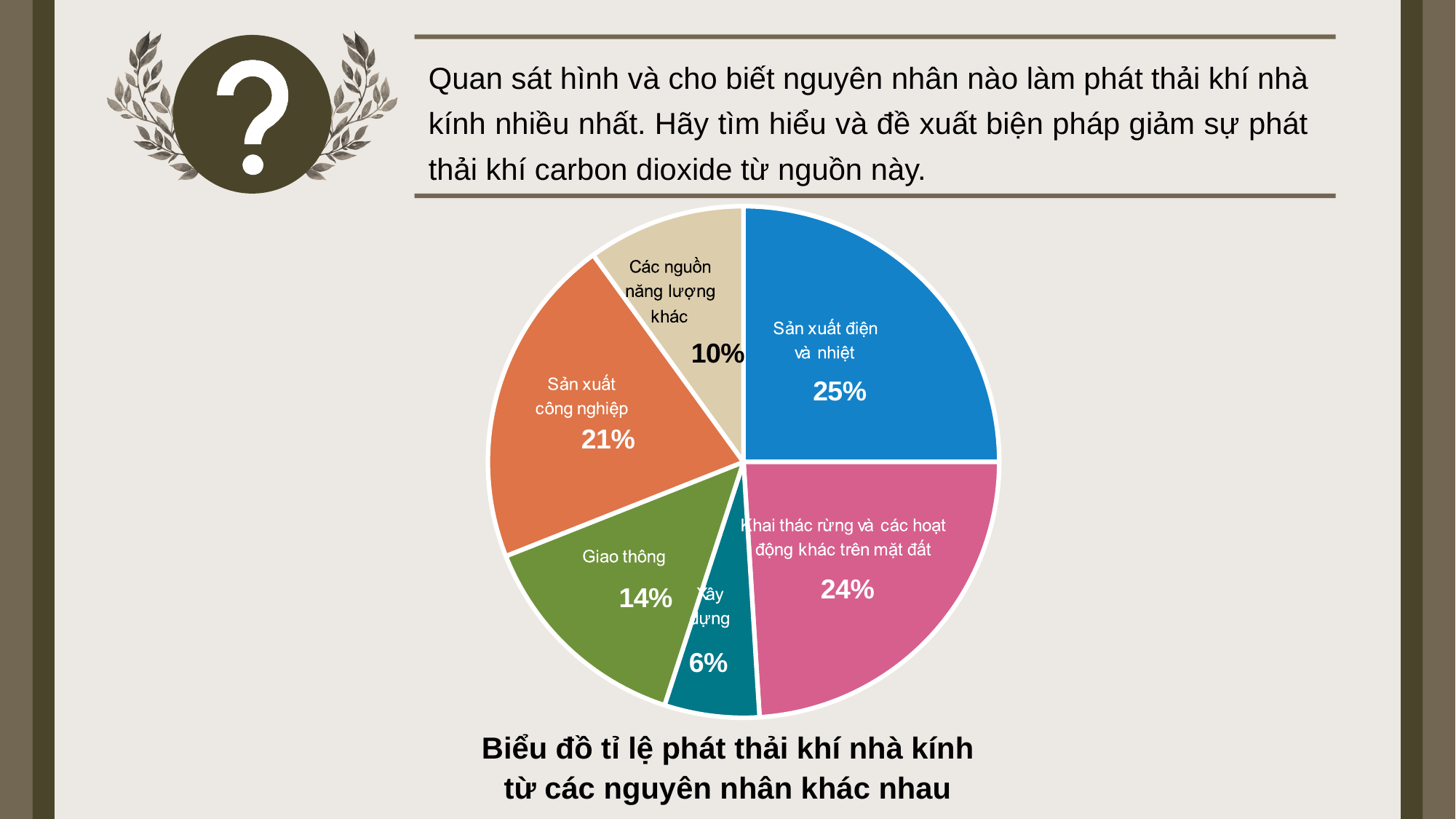
How many slices does the pie chart have? 6 What is the title of the pie chart? Biểu đồ tỉ lệ phát thải khí nhà kính từ các nguyên nhân khác nhau What share of greenhouse gas emissions comes from "Sản xuất điện và nhiệt"? 25% Which is larger: the share for "Khai thác rừng và các hoạt động khác trên mặt đất" or the share for "Sản xuất công nghiệp"? Khai thác rừng và các hoạt động khác trên mặt đất What percentage is shown for "Xây dựng"? 6% Which source has the smallest share of emissions in the pie chart? Xây dựng What kind of chart is shown on the slide? pie chart Which source has the largest share of emissions in the pie chart? Sản xuất điện và nhiệt What percentage is shown for "Giao thông"? 14% What is the difference in percentage points between "Sản xuất công nghiệp" and "Giao thông"? 7 What percentage is shown for "Các nguồn năng lượng khác"? 10% What percentage is shown for "Sản xuất công nghiệp"? 21%